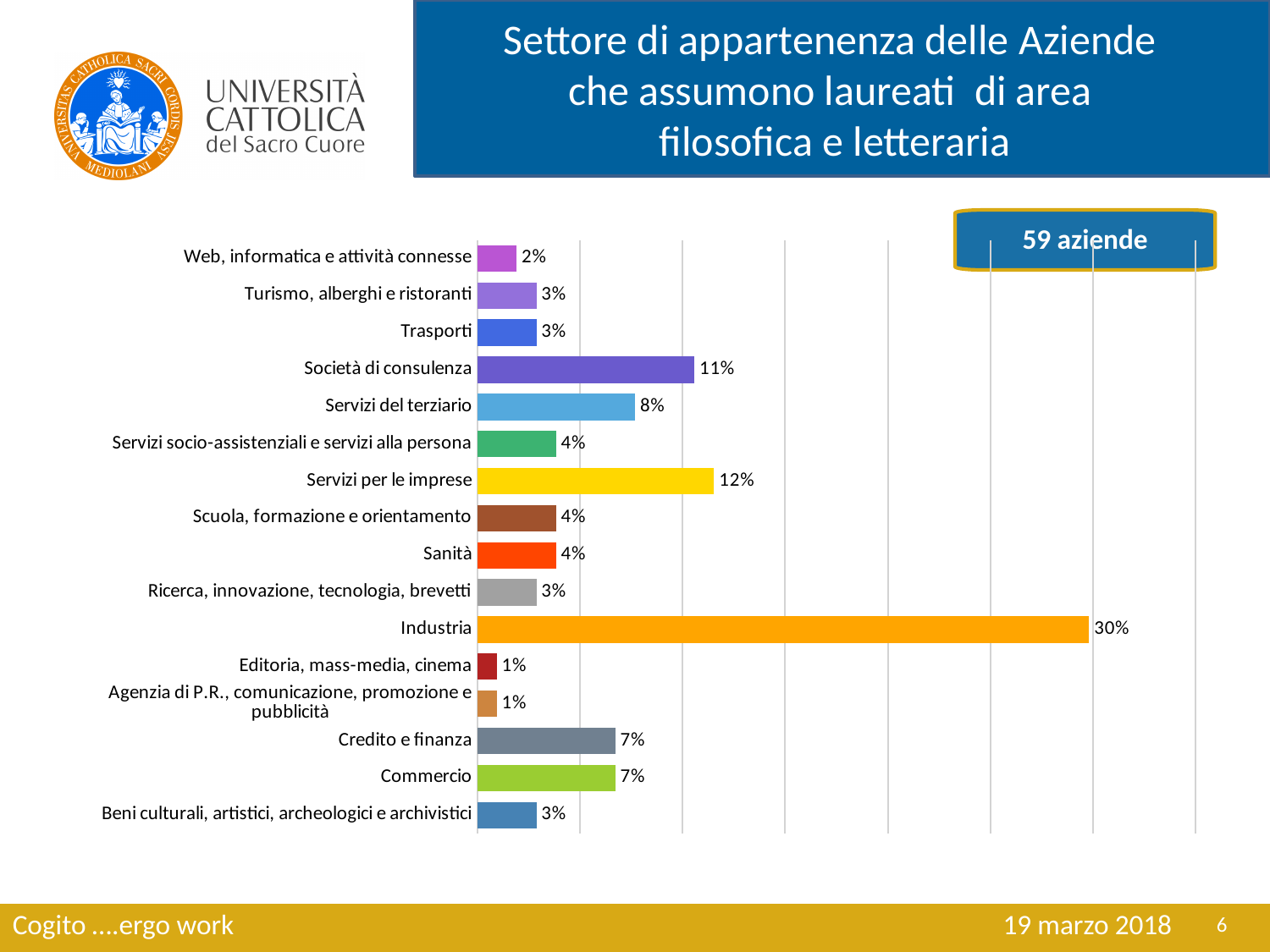
What is the value for Credito e finanza? 7% What is the value for Società di consulenza? 11% How many categories are shown in the chart? 16 What is the value for Servizi del terziario? 8% How many companies (aziende) does the box on the slide say the chart is based on? 59 aziende What kind of chart is shown on the slide? bar chart What is the difference between the values for Società di consulenza and Servizi del terziario? 3% What is the difference between the values for Industria and Servizi per le imprese? 18% Which category has the highest value? Industria What is the value for Servizi per le imprese? 12% What is the value for Industria? 30% Which is larger, the value for Servizi per le imprese or the value for Società di consulenza? Servizi per le imprese